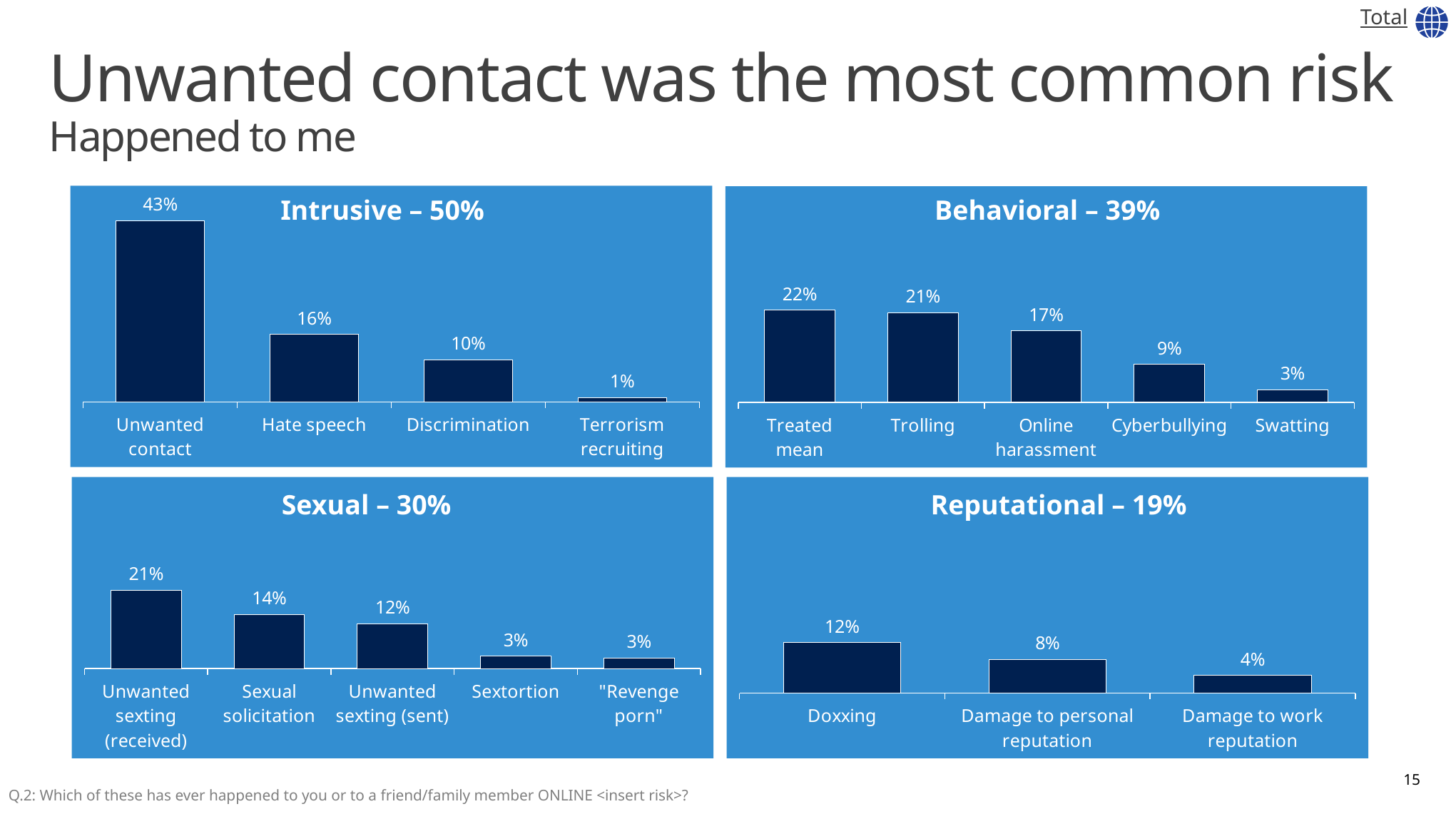
In the Sexual – 30% chart, what is the value for Sexual solicitation? 14% In the Reputational – 19% chart, what is the difference between Doxxing and Damage to personal reputation? 4% In the Reputational – 19% chart, what is the value for Damage to work reputation? 4% What kind of chart is the Sexual – 30% chart? Bar chart In the Intrusive – 50% chart, which category has the lowest value? Terrorism recruiting In the Sexual – 30% chart, which is larger: Unwanted sexting (received) or Unwanted sexting (sent)? Unwanted sexting (received) In the Intrusive – 50% chart, what is the difference between Unwanted contact and Hate speech? 27% In the Behavioral – 39% chart, what is the value for Online harassment? 17% In the Behavioral – 39% chart, which category has the highest value? Treated mean How many categories are shown in the Behavioral – 39% chart? 5 In the Intrusive – 50% chart, what is the value for Unwanted contact? 43% How many categories are shown in the Reputational – 19% chart? 3